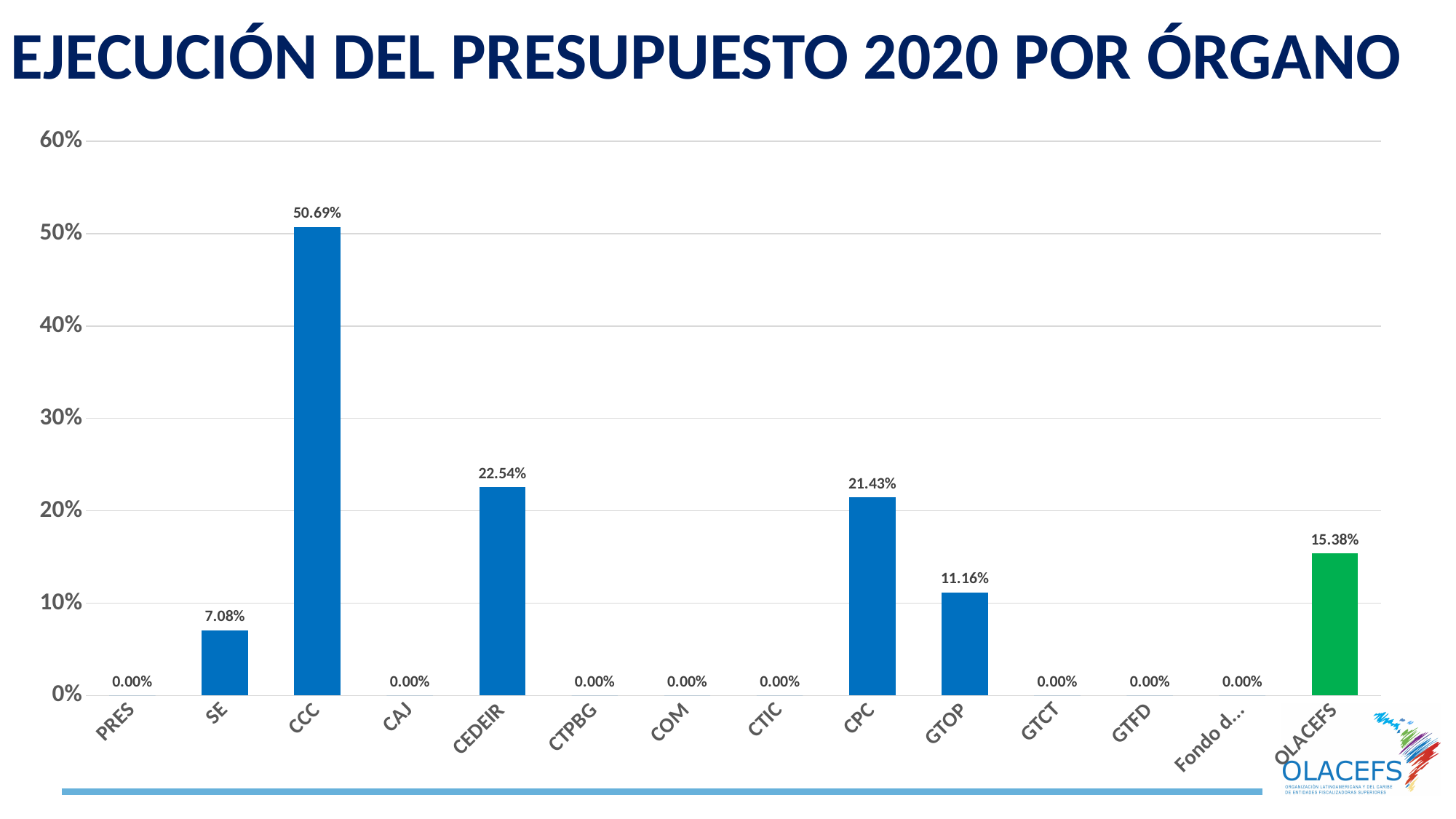
What is the value for GTOP? 11.16% What kind of chart is shown on the slide? bar chart Which is larger, the value for SE or the value for GTOP? GTOP What is the value for CCC? 50.69% How many categories have a value of 0.00%? 8 What is the title of the chart? EJECUCIÓN DEL PRESUPUESTO 2020 POR ÓRGANO What is the value for CEDEIR? 22.54% What is the value for OLACEFS? 15.38% How many categories are shown on the x axis? 14 What is the difference between the values for CEDEIR and CPC? 1.11% Which category has the highest value? CCC Is the value for CCC greater or less than 50%? greater